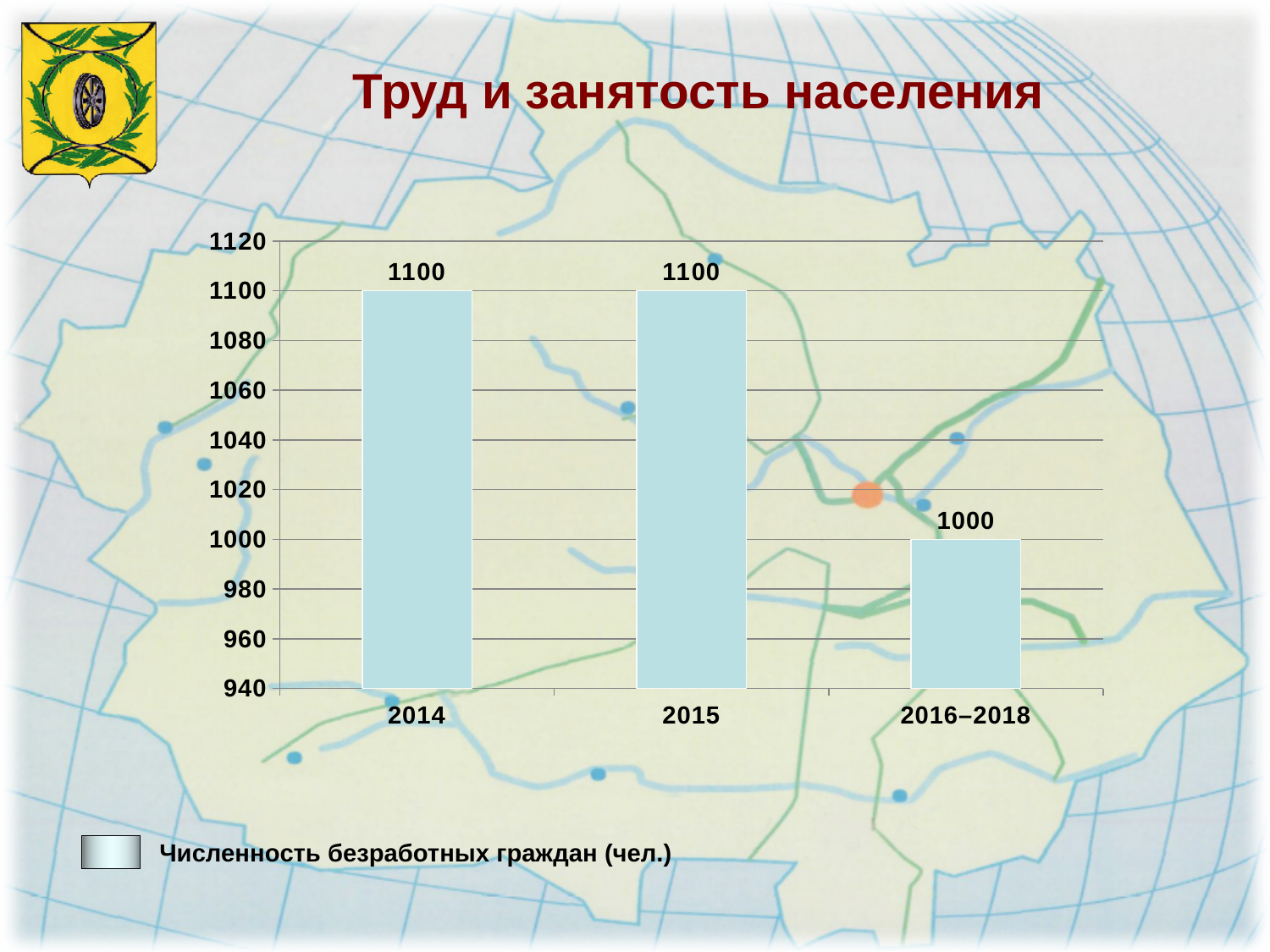
What is the number of unemployed citizens in 2016–2018? 1000 Is the value for 2016–2018 greater or less than 1040? less Which category has the lowest value? 2016–2018 What is the difference between the value for 2015 and the value for 2016–2018? 100 How many categories are shown on the x axis? 3 How many series does the legend list? 1 What is the value shown for 2015? 1100 What is the legend entry for the series shown? Численность безработных граждан (чел.) Which is larger, the value for 2014 or the value for 2016–2018? 2014 What kind of chart is shown on the slide? bar chart What is the number of unemployed citizens in 2014? 1100 Do the values rise or fall from 2015 to 2016–2018? fall